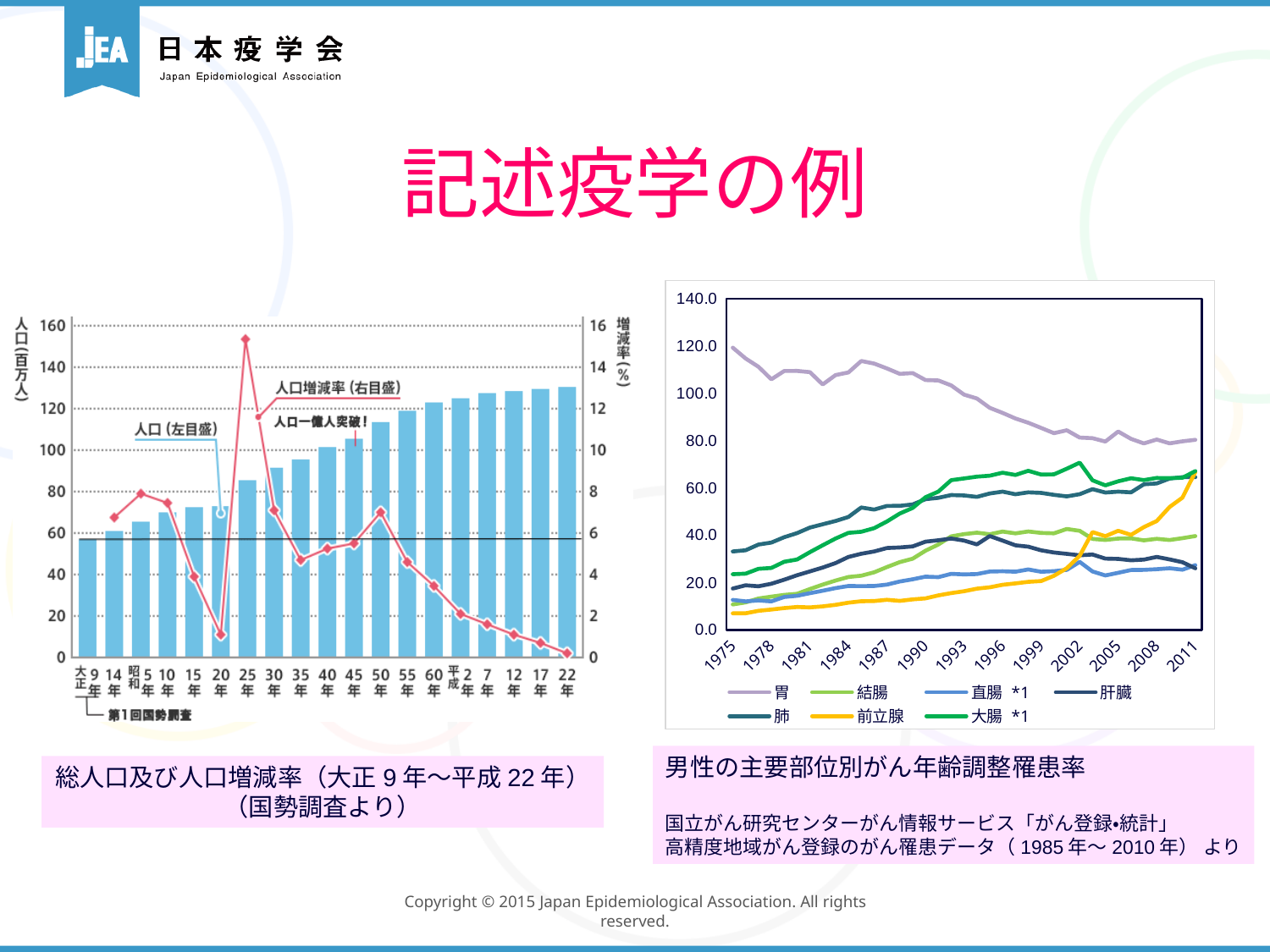
On the right chart (男性の主要部位別がん年齢調整罹患率), does the 胃 series rise or fall from 1975 to 2011? fall On the right chart (男性の主要部位別がん年齢調整罹患率), is the value for 胃 in 1975 greater or less than 100.0? greater On the right chart (男性の主要部位別がん年齢調整罹患率), which is larger in 2011, 胃 or 結腸? 胃 On the right chart (男性の主要部位別がん年齢調整罹患率), which series has the lowest value in 1975? 前立腺 On the left chart (総人口及び人口増減率), in which year does the 人口増減率 line reach its highest value? 昭和25年 On the left chart (総人口及び人口増減率), how many bars are plotted? 19 On the right chart (男性の主要部位別がん年齢調整罹患率), is the value for 前立腺 in 1975 greater or less than 20.0? less What kind of chart is the right chart (男性の主要部位別がん年齢調整罹患率)? line chart On the right chart (男性の主要部位別がん年齢調整罹患率), how many series does the legend list? 7 On the right chart (男性の主要部位別がん年齢調整罹患率), does the 前立腺 series rise or fall from 1975 to 2011? rise On the right chart (男性の主要部位別がん年齢調整罹患率), which series has the highest value in 1975? 胃 On the left chart (総人口及び人口増減率), is the 人口 value for 平成22年 greater or less than 120? greater